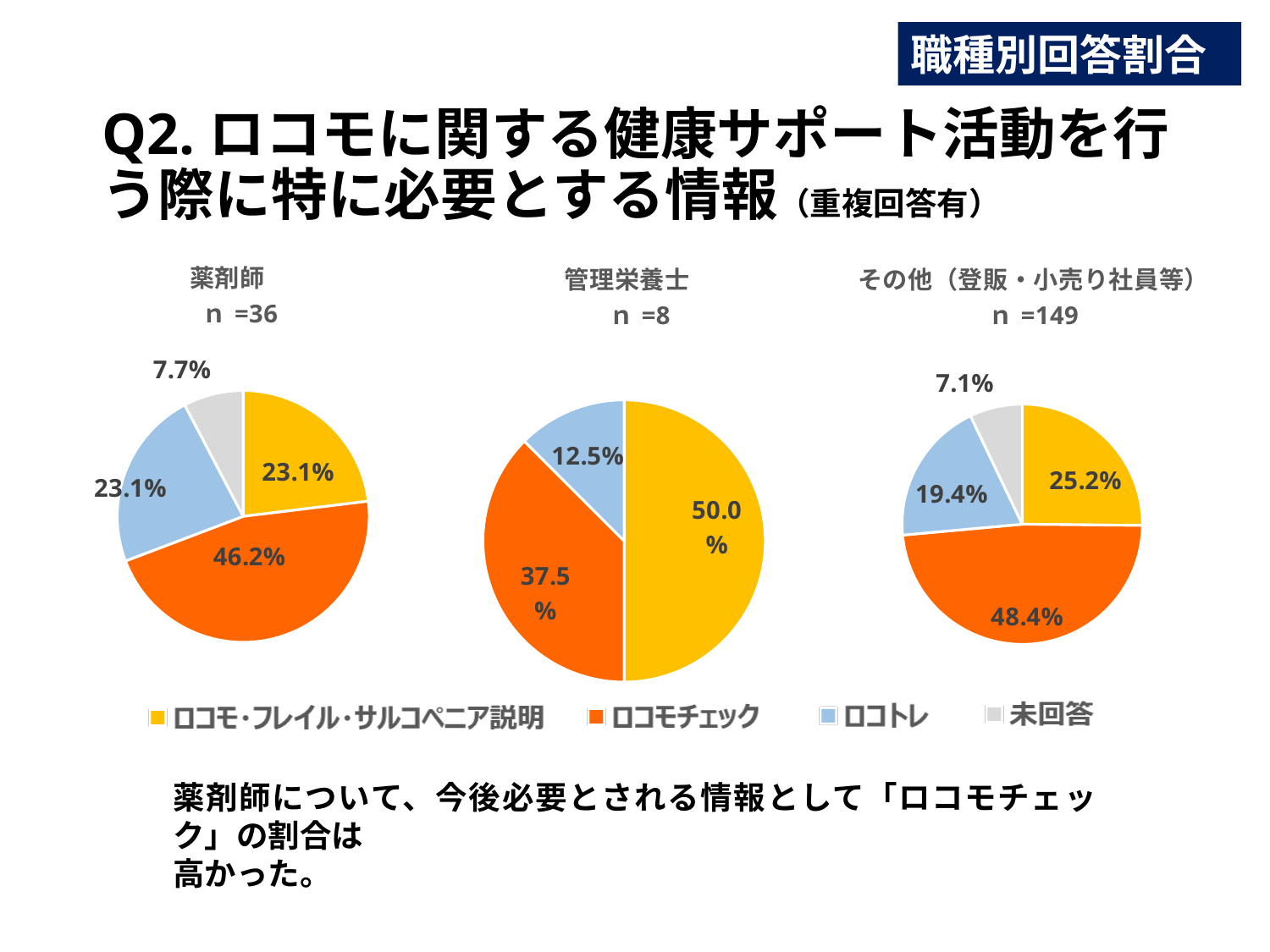
In the その他（登販・小売り社員等） pie chart, which category has the largest share? ロコモチェック How many entries does the legend list? 4 What type of chart is used for the 薬剤師 data? Pie chart In the 薬剤師 pie chart, what is the difference between the shares for ロコモチェック and ロコトレ? 23.1% In the その他（登販・小売り社員等） pie chart, what is the share for ロコトレ? 19.4% In the 薬剤師 pie chart, what is the share for ロコモチェック? 46.2% In the その他（登販・小売り社員等） pie chart, what is the share for 未回答? 7.1% In the 管理栄養士 pie chart, which category has the smallest share? ロコトレ In the 薬剤師 pie chart, which category has the largest share? ロコモチェック In the 管理栄養士 pie chart, what is the share for ロコモ・フレイル・サルコペニア説明? 50.0% How many slices does the 管理栄養士 pie chart have? 3 In the 管理栄養士 pie chart, which is larger: the share for ロコモチェック or the share for ロコトレ? ロコモチェック